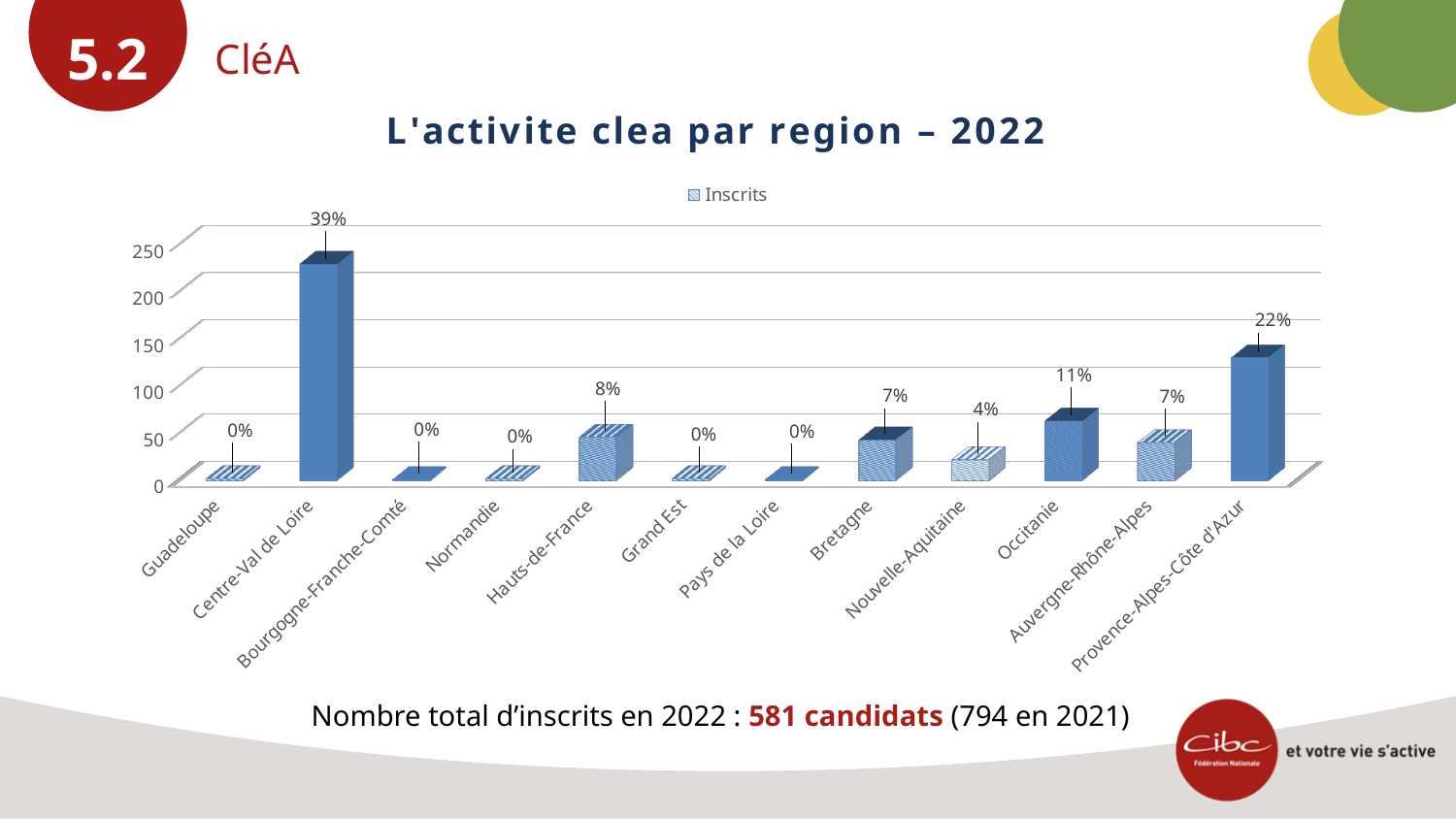
Which has the larger value, Occitanie or Bretagne? Occitanie What type of chart is shown on the slide? bar chart What is the data label shown for Provence-Alpes-Côte d'Azur? 22% How many series does the legend list, and what is it called? 1, Inscrits Is the bar for Centre-Val de Loire greater or less than 200 on the vertical axis? greater What is the data label shown for Hauts-de-France? 8% Which region has the highest value in the chart? Centre-Val de Loire What is the data label shown for Centre-Val de Loire? 39% How many regions are shown on the x axis of the chart? 12 Is the bar for Provence-Alpes-Côte d'Azur greater or less than 100 on the vertical axis? greater What is the difference in percentage points between the labels for Centre-Val de Loire and Provence-Alpes-Côte d'Azur? 17% What is the data label shown for Occitanie? 11%